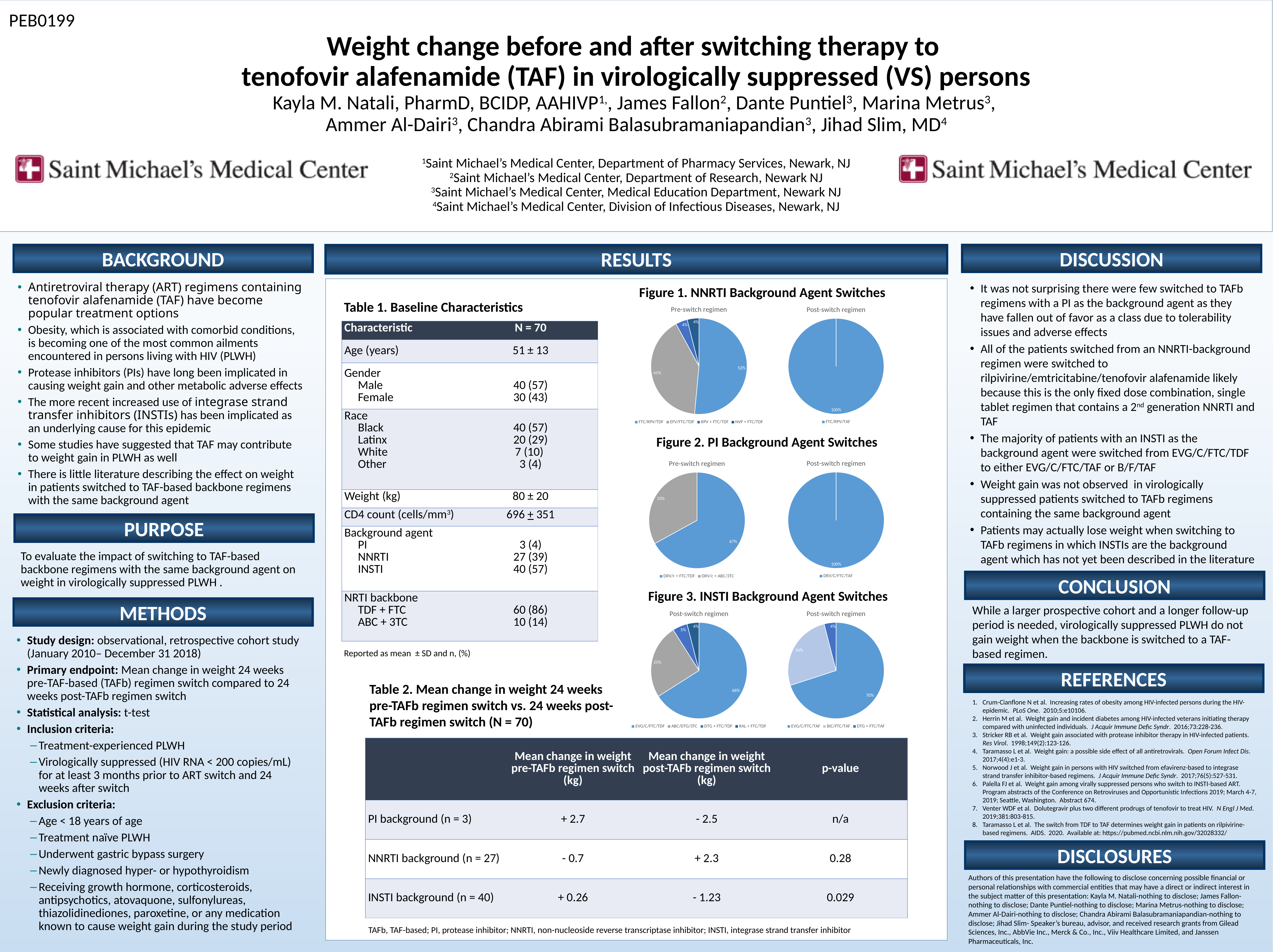
In the Post-switch regimen pie of Figure 1. NNRTI Background Agent Switches, what share is shown for FTC/RPV/TAF? 100% How many slices does the Pre-switch regimen pie in Figure 2. PI Background Agent Switches have? 2 In the Pre-switch regimen pie of Figure 1. NNRTI Background Agent Switches, what share is labelled for EFV/FTC/TDF? 41% How many entries does the legend of the Pre-switch regimen pie in Figure 1. NNRTI Background Agent Switches list? 4 In the Pre-switch regimen pie of Figure 2. PI Background Agent Switches, what is the difference in percentage points between the two slices? 34 In the left pie of Figure 3. INSTI Background Agent Switches, what is the share of the largest slice? 66% In the Pre-switch regimen pie of Figure 2. PI Background Agent Switches, what share is shown for DRV/r + FTC/TDF? 67% What kind of chart is used in Figure 1. NNRTI Background Agent Switches? Pie chart How many entries does the legend of the right pie in Figure 3. INSTI Background Agent Switches list? 3 In the Pre-switch regimen pie of Figure 1. NNRTI Background Agent Switches, what is the share of the largest slice? 52% In the left pie of Figure 3. INSTI Background Agent Switches, which slice is larger: ABC/DTG/3TC or DTG + FTC/TDF? ABC/DTG/3TC